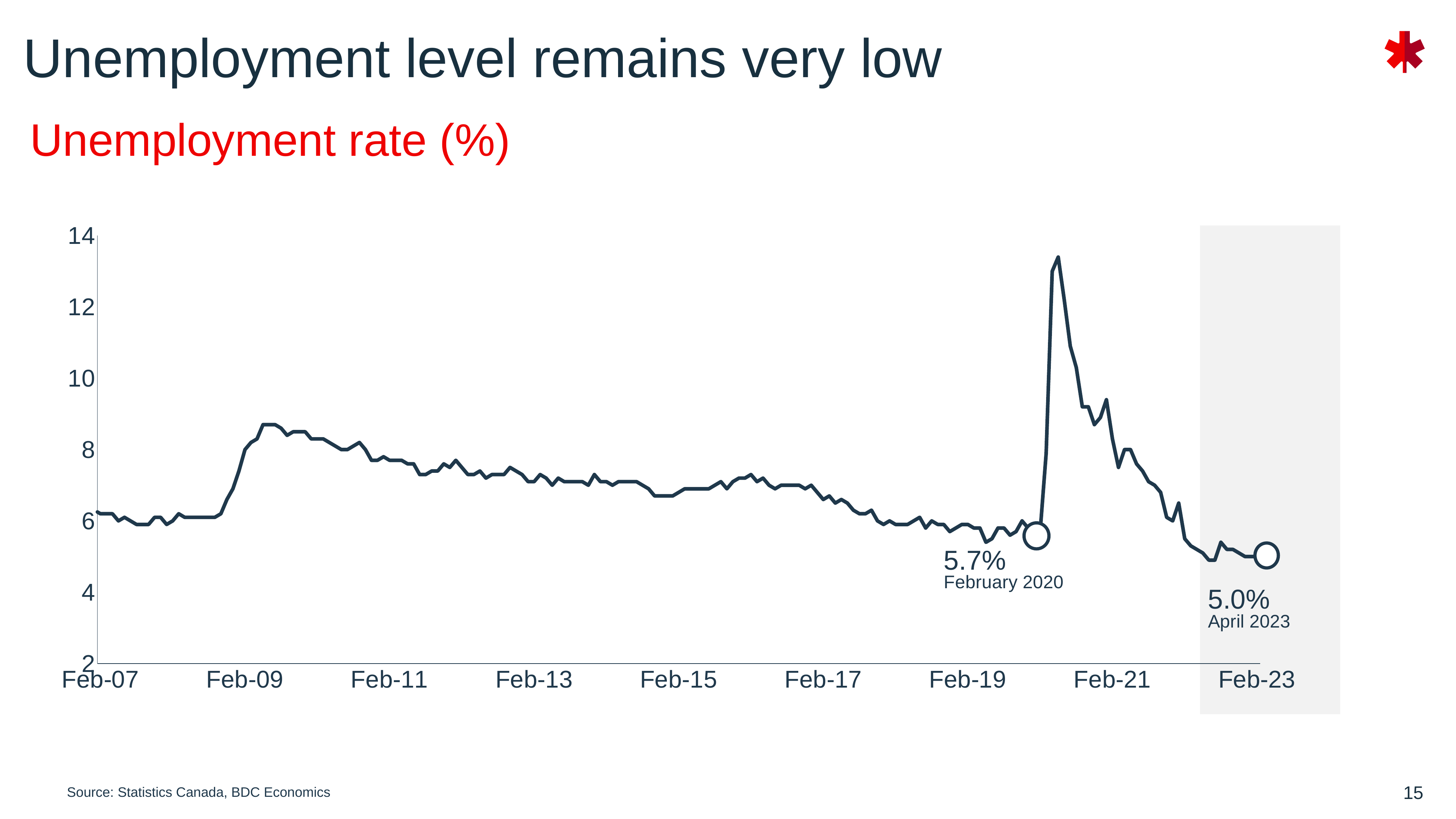
In which year does the unemployment rate reach its highest point on the chart? 2020 Between Feb-11 and Feb-19, does the unemployment rate overall rise or fall? fall By how many percentage points does the labelled February 2020 value exceed the labelled April 2023 value? 0.7 What kind of chart is shown on the slide? line chart Is the unemployment rate at Feb-17 greater or less than 8? less What unemployment rate is labelled for February 2020? 5.7% Which labelled point is higher: February 2020 or April 2023? February 2020 Is the unemployment rate at Feb-11 greater or less than 6? greater What is the title of the chart? Unemployment rate (%) Is the unemployment rate at Feb-07 greater or less than 8? less What unemployment rate is labelled for April 2023? 5.0%